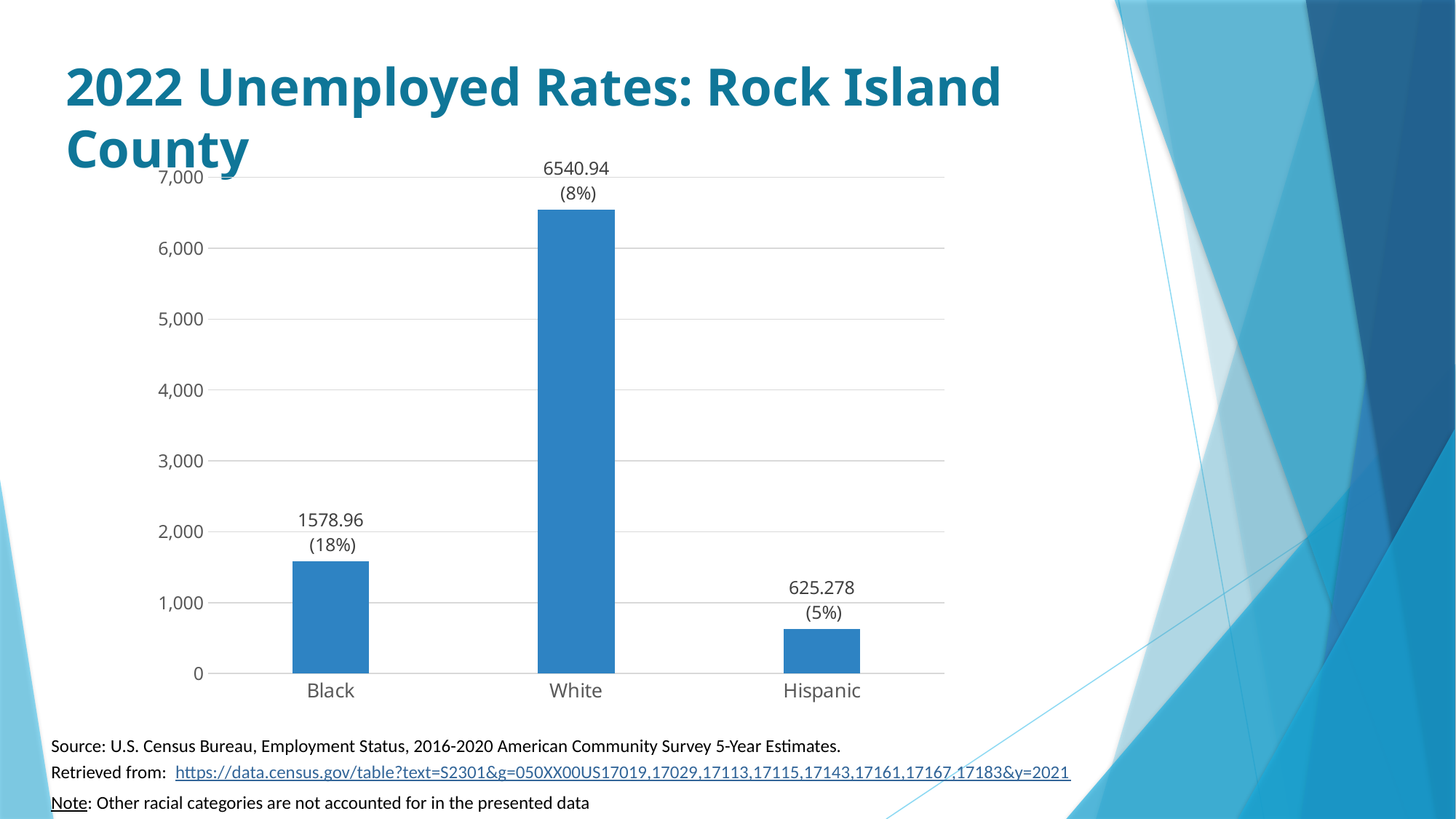
What percentage is shown in parentheses for Hispanic? 5% Which category has the highest bar? White What is the difference between the values for Black and Hispanic? 953.682 What kind of chart is shown on the slide? Bar chart What is the value shown for Hispanic? 625.278 Which is larger, the value for Black or the value for Hispanic? Black What is the difference between the values for White and Black? 4961.98 What percentage is shown in parentheses for Black? 18% What is the value shown for White? 6540.94 How many categories are shown on the x axis? 3 What is the value shown for Black? 1578.96 Which category has the lowest bar? Hispanic